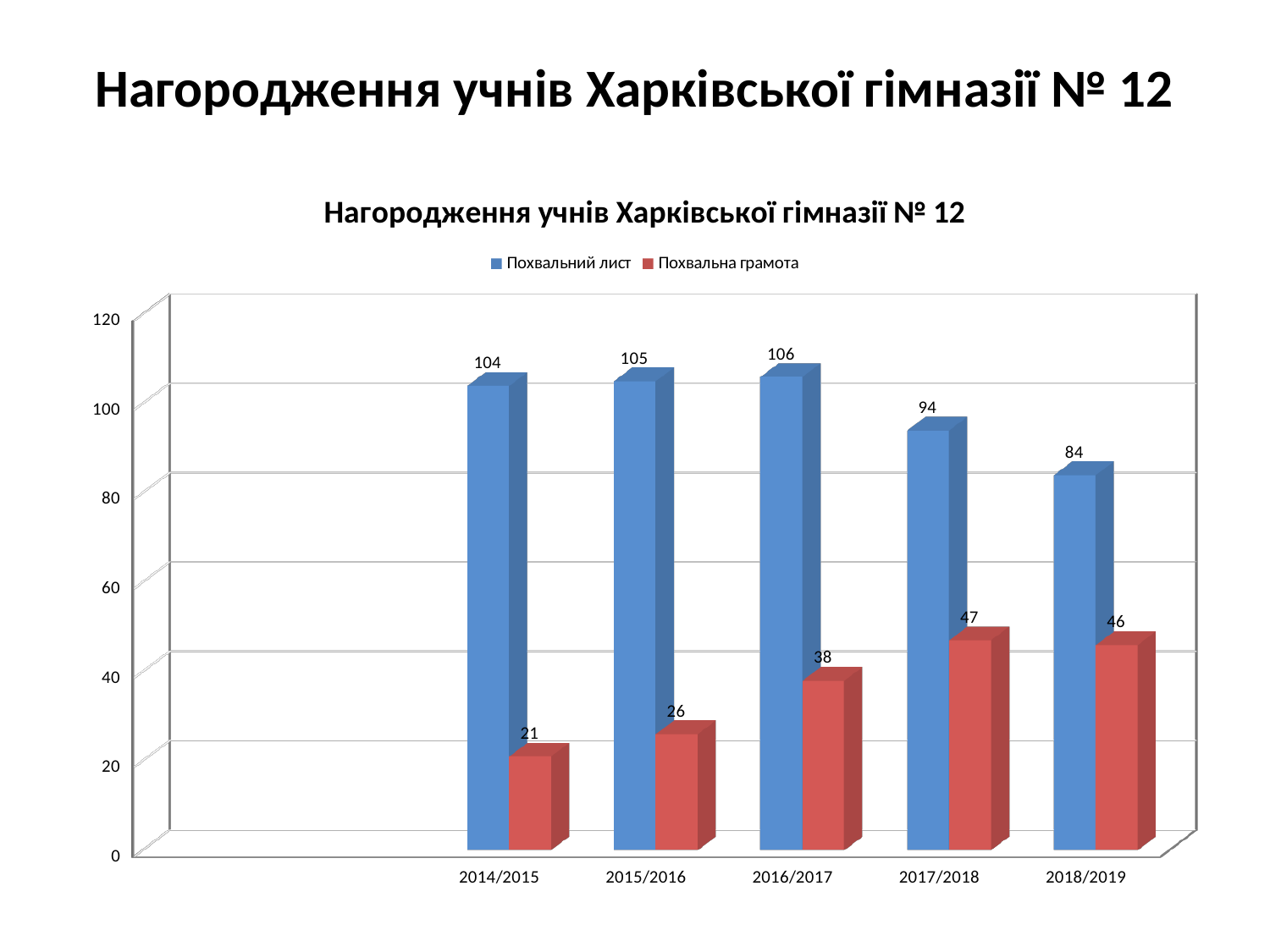
What is the value of Похвальний лист for 2016/2017? 106 Which is larger: Похвальна грамота in 2015/2016 or in 2016/2017? 2016/2017 What is the difference between Похвальний лист and Похвальна грамота in 2017/2018? 47 What is the value of Похвальна грамота for 2014/2015? 21 What is the value of Похвальна грамота for 2018/2019? 46 Is the value of Похвальний лист for 2018/2019 greater or less than 100? less How many school years are shown on the x axis? 5 Does the value of Похвальний лист rise or fall from 2016/2017 to 2018/2019? fall How many series does the legend list? 2 Which year has the highest value for Похвальний лист? 2016/2017 What kind of chart is shown on the slide? bar chart Which year has the lowest value for Похвальна грамота? 2014/2015